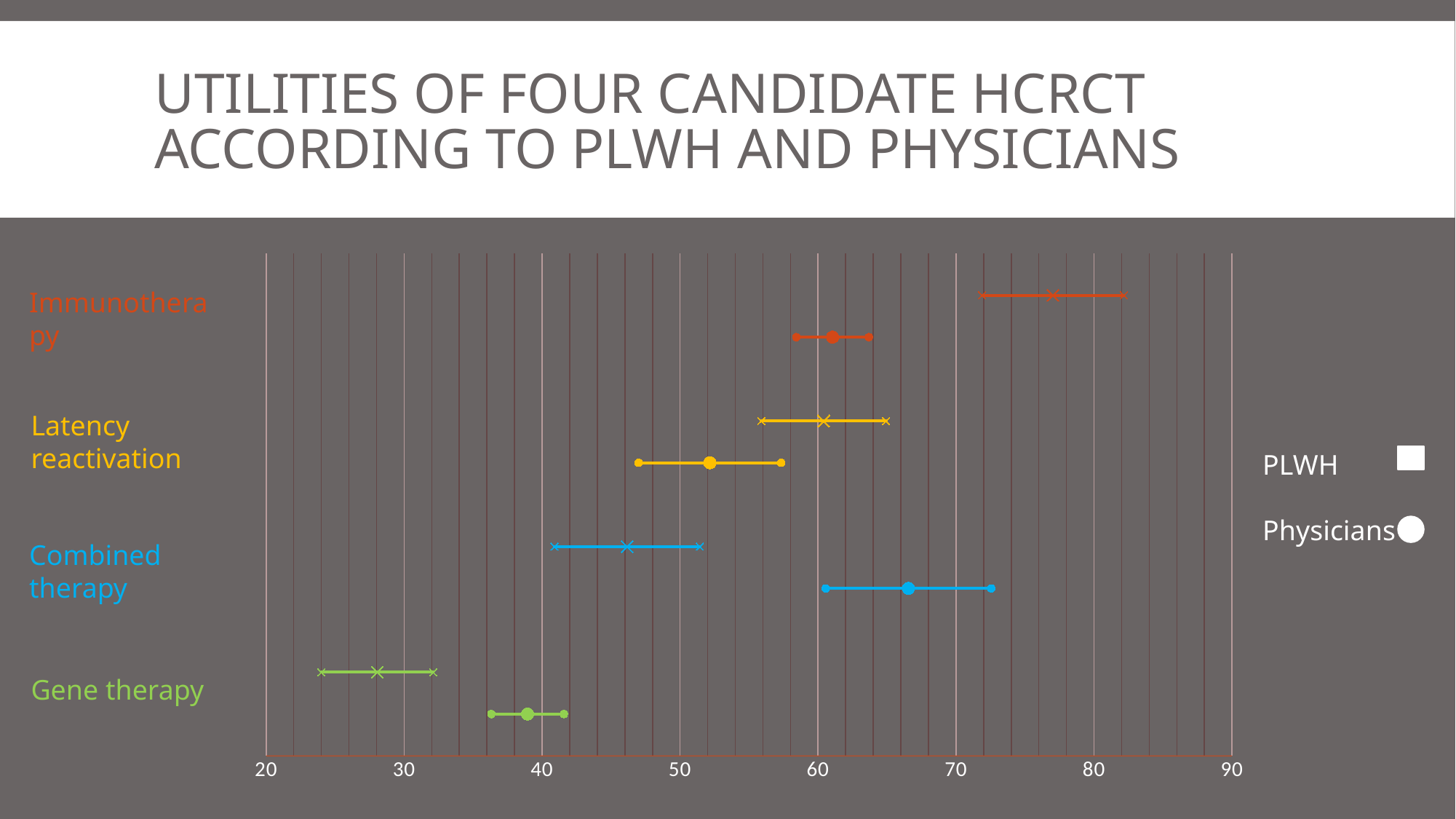
Which therapy has the highest Physicians utility value? Combined therapy How many candidate therapies are plotted on the chart? 4 Is the PLWH value for Combined therapy greater or less than 50? less Which therapy has the lowest PLWH utility value? Gene therapy For Immunotherapy, which group gives the higher utility value, PLWH or Physicians? PLWH Which therapy has the lowest Physicians utility value? Gene therapy Is the PLWH value for Immunotherapy greater or less than 70? greater Which therapy has the highest PLWH utility value? Immunotherapy For Combined therapy, which group gives the higher utility value, PLWH or Physicians? Physicians How many series does the legend list? 2 Is the Physicians value for Combined therapy greater or less than 60? greater